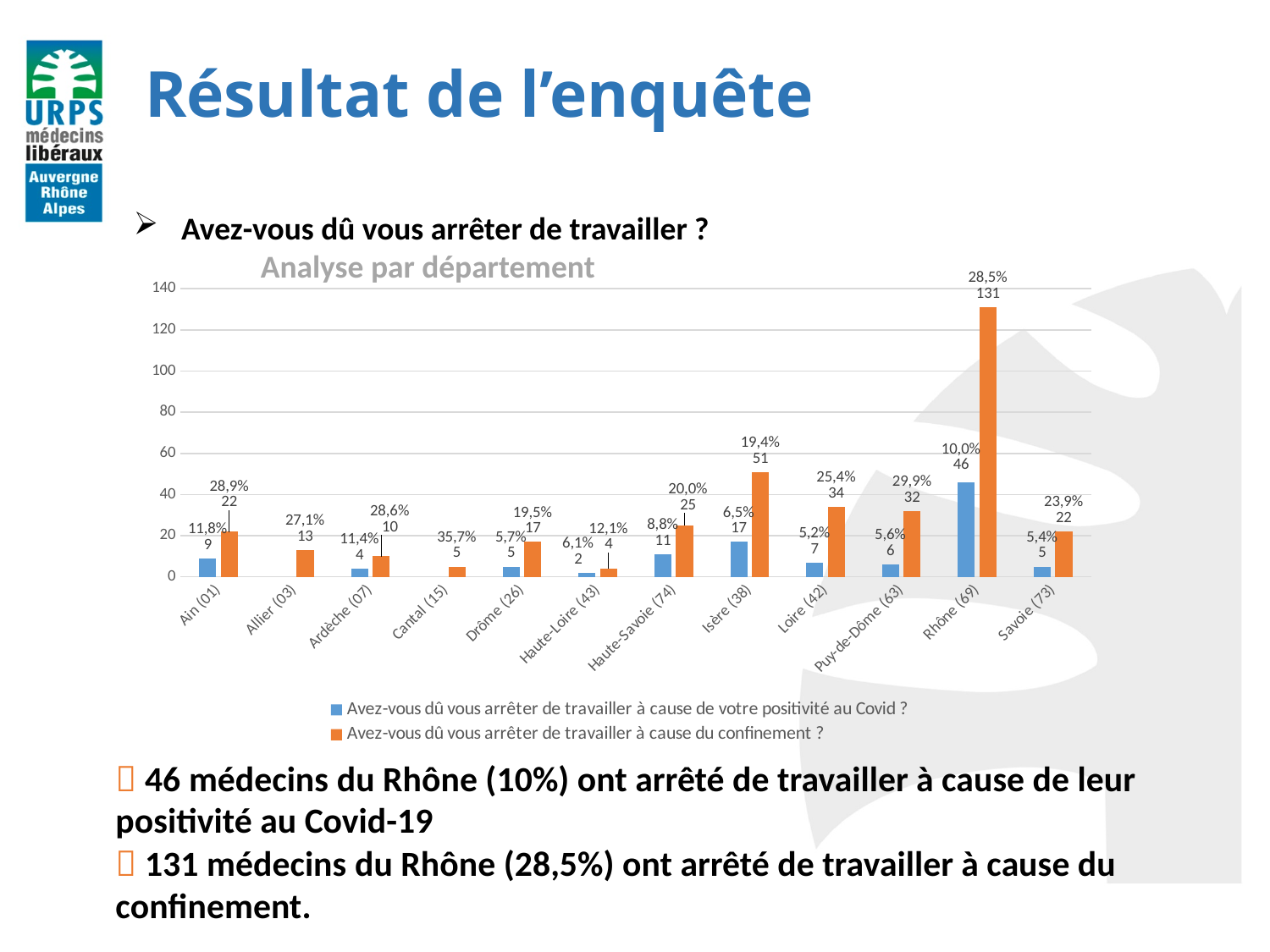
What percentage is shown for Cantal (15) for stopping work because of the confinement? 35,7% Which has more médecins who stopped working because of the confinement: Isère (38) or Loire (42)? Isère (38) How many départements are shown on the x axis of the chart? 12 How many series does the chart legend list? 2 Which département has the highest number of médecins who stopped working because of the confinement? Rhône (69) What is the difference between the number of médecins in Rhône (69) who stopped because of the confinement and those who stopped because of Covid positivity? 85 What type of chart is shown on the slide? Bar chart How many médecins in Isère (38) stopped working because of their Covid positivity? 17 What is the title of the chart? Analyse par département Is the value for Rhône (69) for stopping work because of the confinement greater or less than 120? greater How many médecins in Rhône (69) stopped working because of the confinement? 131 Which département has the lowest number of médecins who stopped working because of the confinement? Haute-Loire (43)